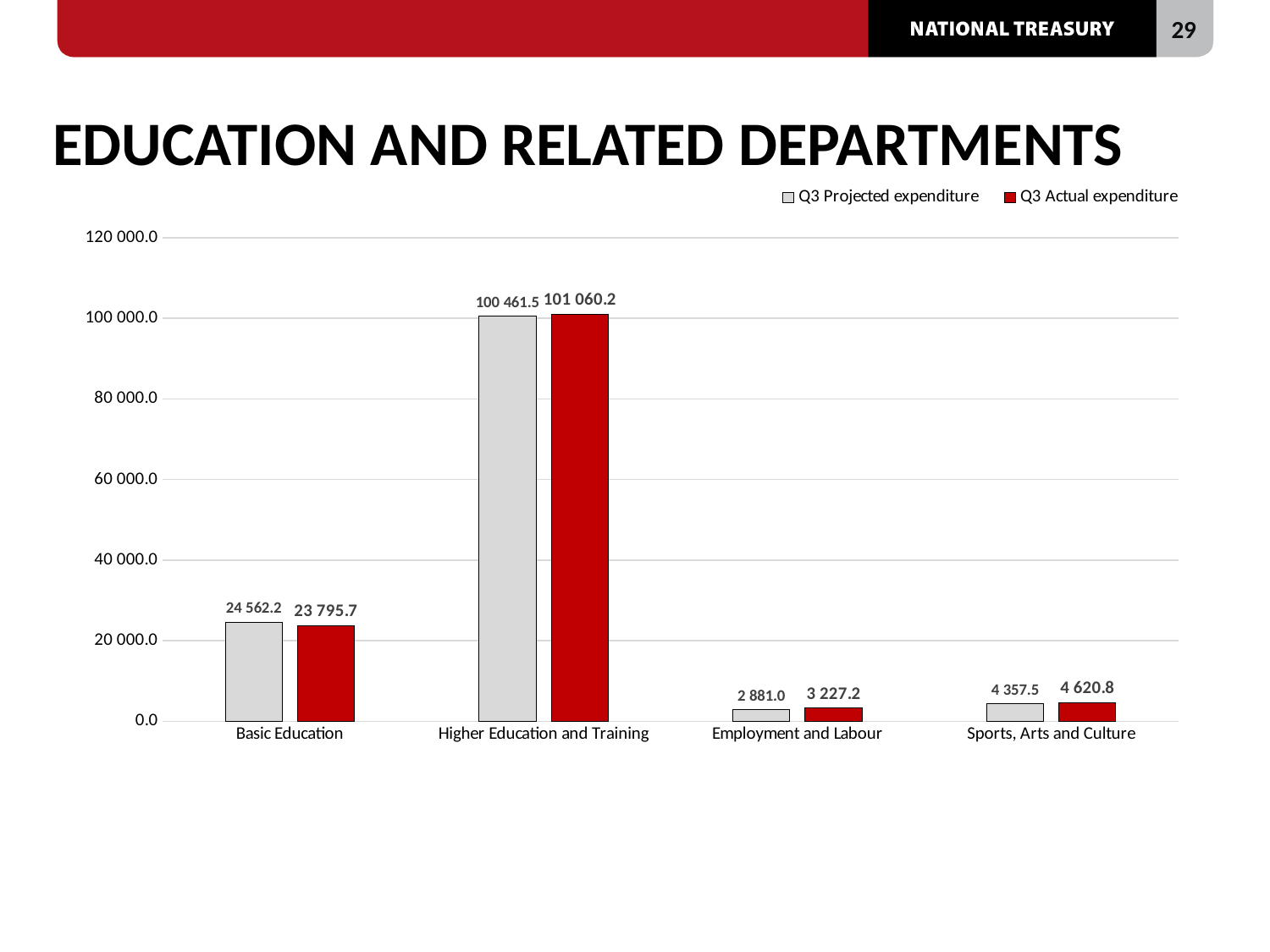
What is the difference between the Q3 Projected and Q3 Actual expenditure for Basic Education? 766.5 What is the Q3 Actual expenditure for Sports, Arts and Culture? 4 620.8 Which department has the highest Q3 Actual expenditure? Higher Education and Training What type of chart is shown on the slide? Bar chart What is the Q3 Projected expenditure for Employment and Labour? 2 881.0 What is the Q3 Actual expenditure for Higher Education and Training? 101 060.2 For Basic Education, which is larger: the Q3 Projected expenditure or the Q3 Actual expenditure? Q3 Projected expenditure What is the difference between the Q3 Actual and Q3 Projected expenditure for Employment and Labour? 346.2 How many series does the chart legend list? 2 What is the Q3 Projected expenditure for Basic Education? 24 562.2 How many departments are shown on the x axis of the chart? 4 Which department has the lowest Q3 Projected expenditure? Employment and Labour